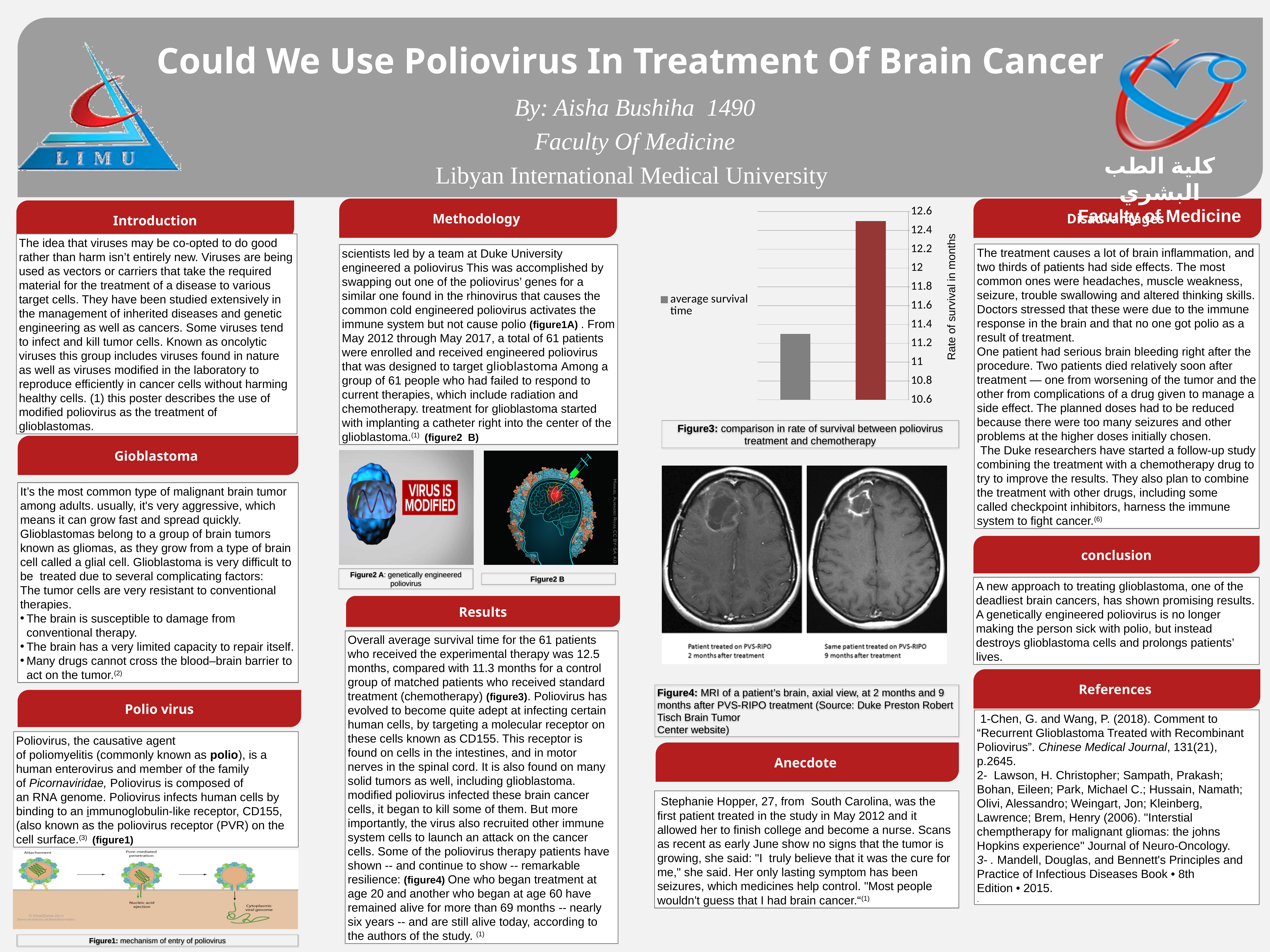
How many bars are plotted in the chart? 2 Which bar is taller, the left (gray) bar or the right (red) bar? the right (red) bar Is the value of the right (red) bar greater or less than 12? greater Is the value of the right (red) bar greater or less than 12.6? less What is the highest tick value shown on the chart's vertical axis? 12.6 Is the value of the left (gray) bar greater or less than 12? less What kind of chart is shown on the slide? bar chart What is the label on the vertical axis of the chart? Rate of survival in months How many series does the chart's legend list? 1 What is the legend entry of the chart? average survival time